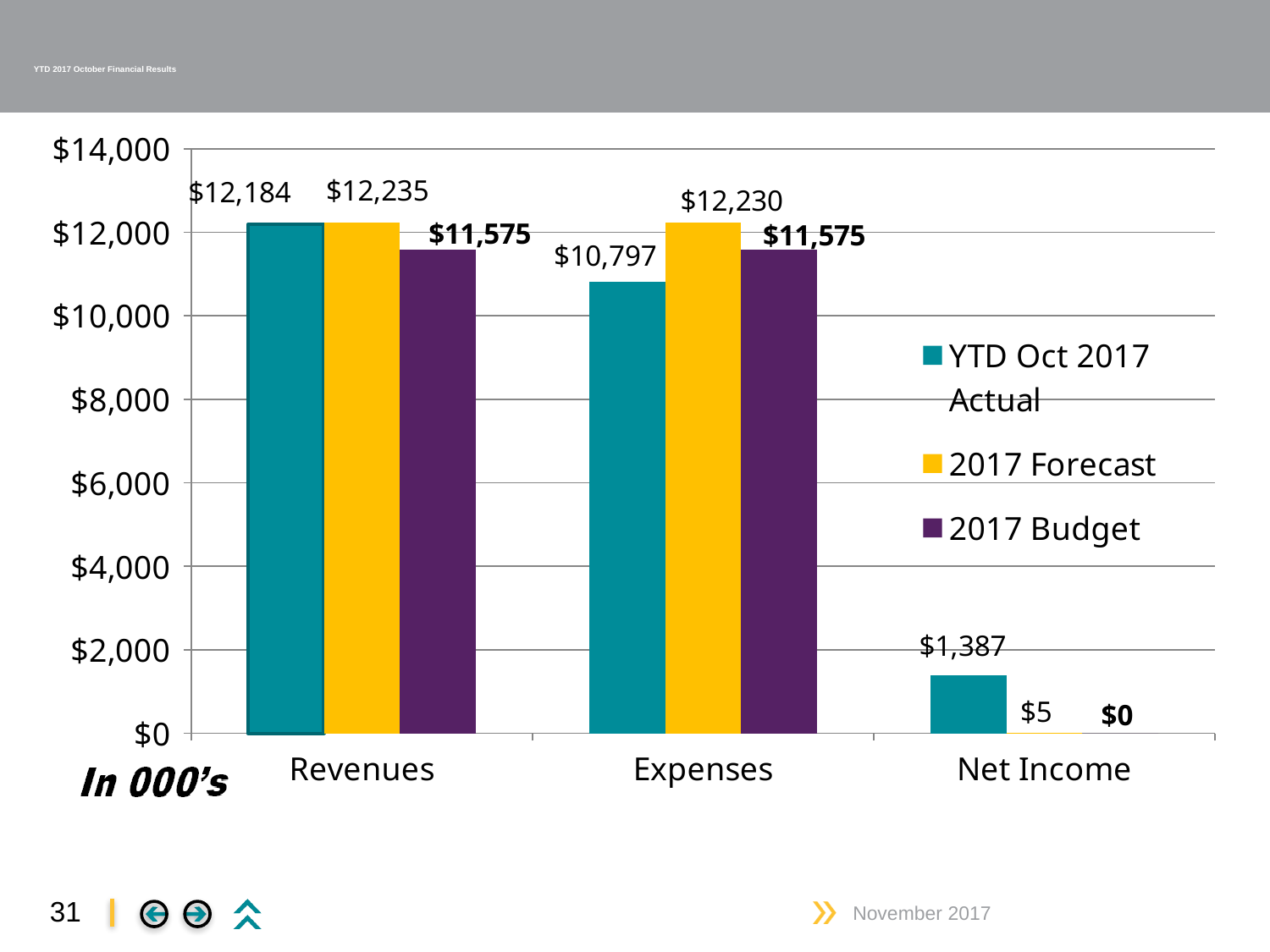
Is the YTD Oct 2017 Actual value for Expenses greater or less than $12,000? less Which is larger: the 2017 Forecast value for Revenues or the 2017 Forecast value for Expenses? 2017 Forecast value for Revenues What is the difference between the YTD Oct 2017 Actual Revenues and the YTD Oct 2017 Actual Expenses? $1,387 What is the 2017 Forecast value for Expenses? $12,230 What is the 2017 Budget value for Net Income? $0 Which category has the lowest YTD Oct 2017 Actual value? Net Income What is the YTD Oct 2017 Actual value for Net Income? $1,387 How many series does the legend list? 3 What kind of chart is shown on the slide? Bar chart What is the YTD Oct 2017 Actual value for Revenues? $12,184 How many categories are shown on the x axis? 3 Which series has the highest value for Revenues? 2017 Forecast